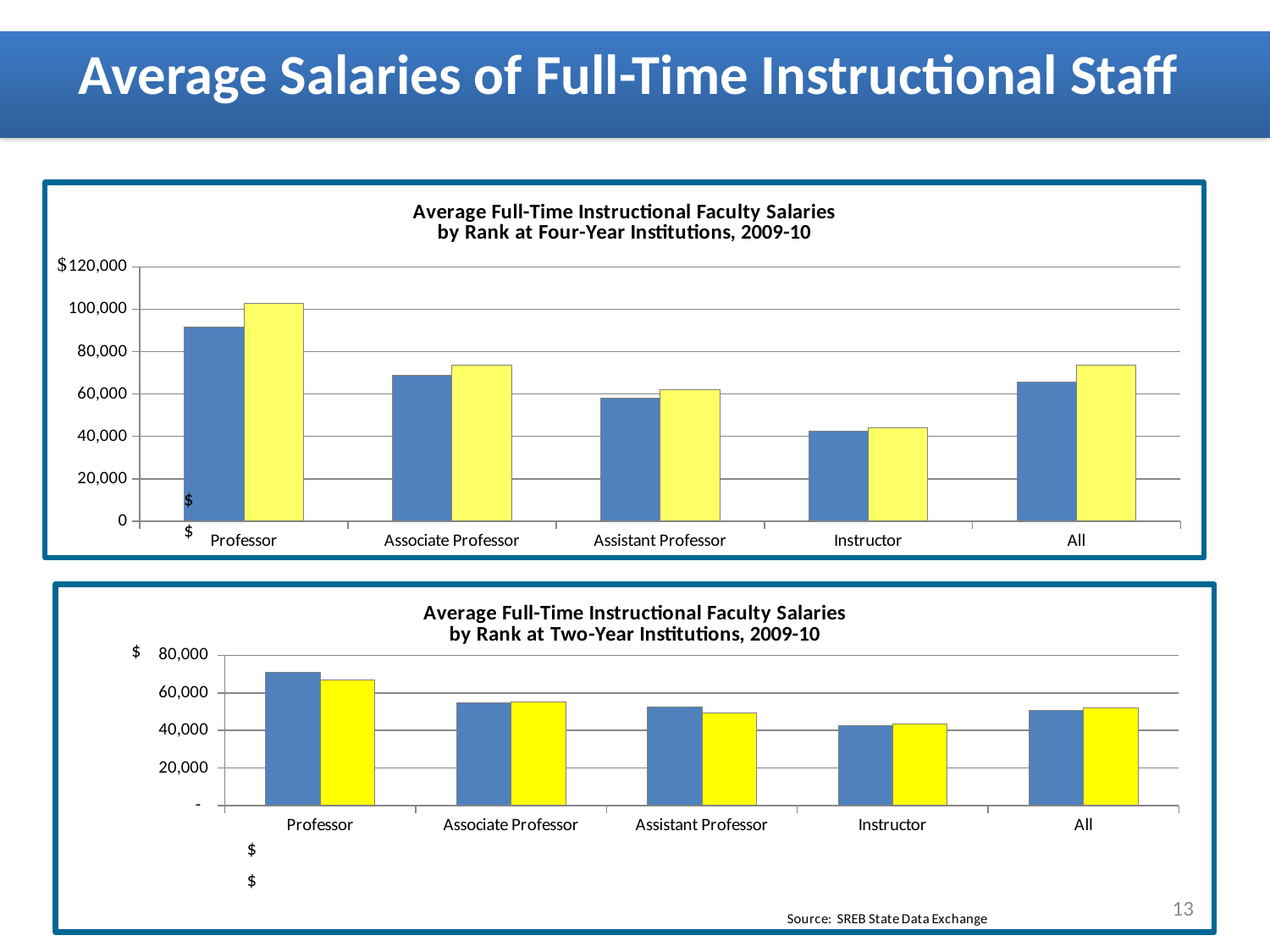
In the top chart (Four-Year Institutions), is the blue bar for Professor greater or less than 80,000? greater In the top chart (Four-Year Institutions), is the blue bar for Instructor greater or less than 60,000? less In the bottom chart (Two-Year Institutions), for Professor, which bar is taller, the blue bar or the yellow bar? The blue bar What is the title of the bottom chart on the slide? Average Full-Time Instructional Faculty Salaries by Rank at Two-Year Institutions, 2009-10 In the top chart (Four-Year Institutions), for Professor, which bar is taller, the blue bar or the yellow bar? The yellow bar In the top chart (Four-Year Institutions), which rank category has the highest salary bar? Professor In the top chart (Four-Year Institutions), which rank category has the lowest salary bars? Instructor What kind of chart is the top chart, 'Average Full-Time Instructional Faculty Salaries by Rank at Four-Year Institutions, 2009-10'? Bar chart In the top chart (Four-Year Institutions), do the salary bars rise or fall moving from Professor to Instructor along the x axis? Fall In the top chart (Four-Year Institutions), how many rank categories are shown on the x axis? 5 In the bottom chart (Two-Year Institutions), which rank category has the highest salary bar? Professor In the bottom chart (Two-Year Institutions), which rank category has the lowest salary bars? Instructor